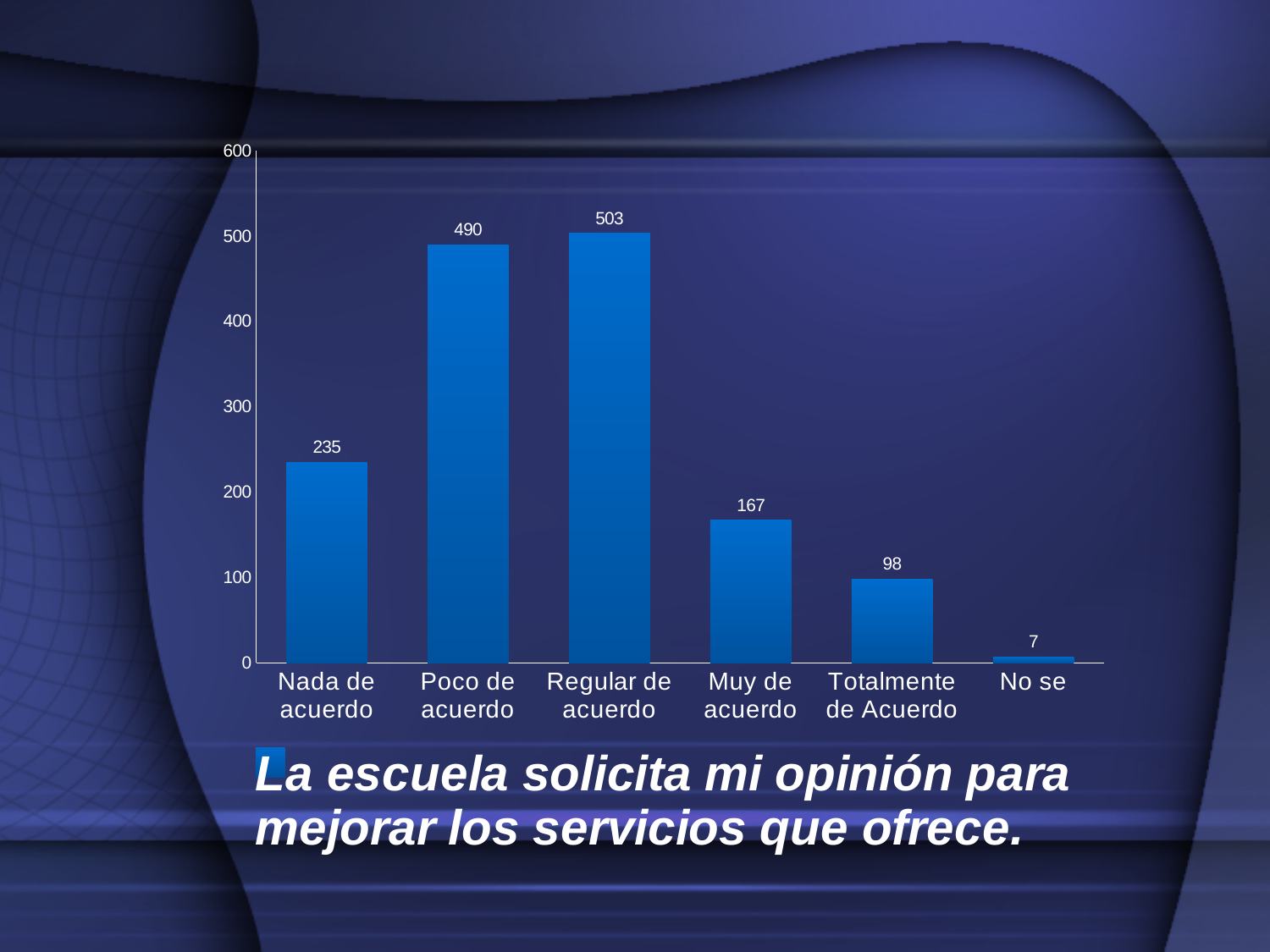
What is the value for "No se"? 7 How many categories are shown on the x axis? 6 What is the text shown below the chart? La escuela solicita mi opinión para mejorar los servicios que ofrece. What is the difference between the values for "Regular de acuerdo" and "Poco de acuerdo"? 13 Which category has the lowest value? No se What is the value for "Nada de acuerdo"? 235 What kind of chart is shown on the slide? bar chart What is the difference between the values for "Nada de acuerdo" and "Totalmente de Acuerdo"? 137 What is the value for "Muy de acuerdo"? 167 Which category has the highest value? Regular de acuerdo Which is larger, the value for "Nada de acuerdo" or the value for "Muy de acuerdo"? Nada de acuerdo Is the value for "Totalmente de Acuerdo" greater or less than 100? less